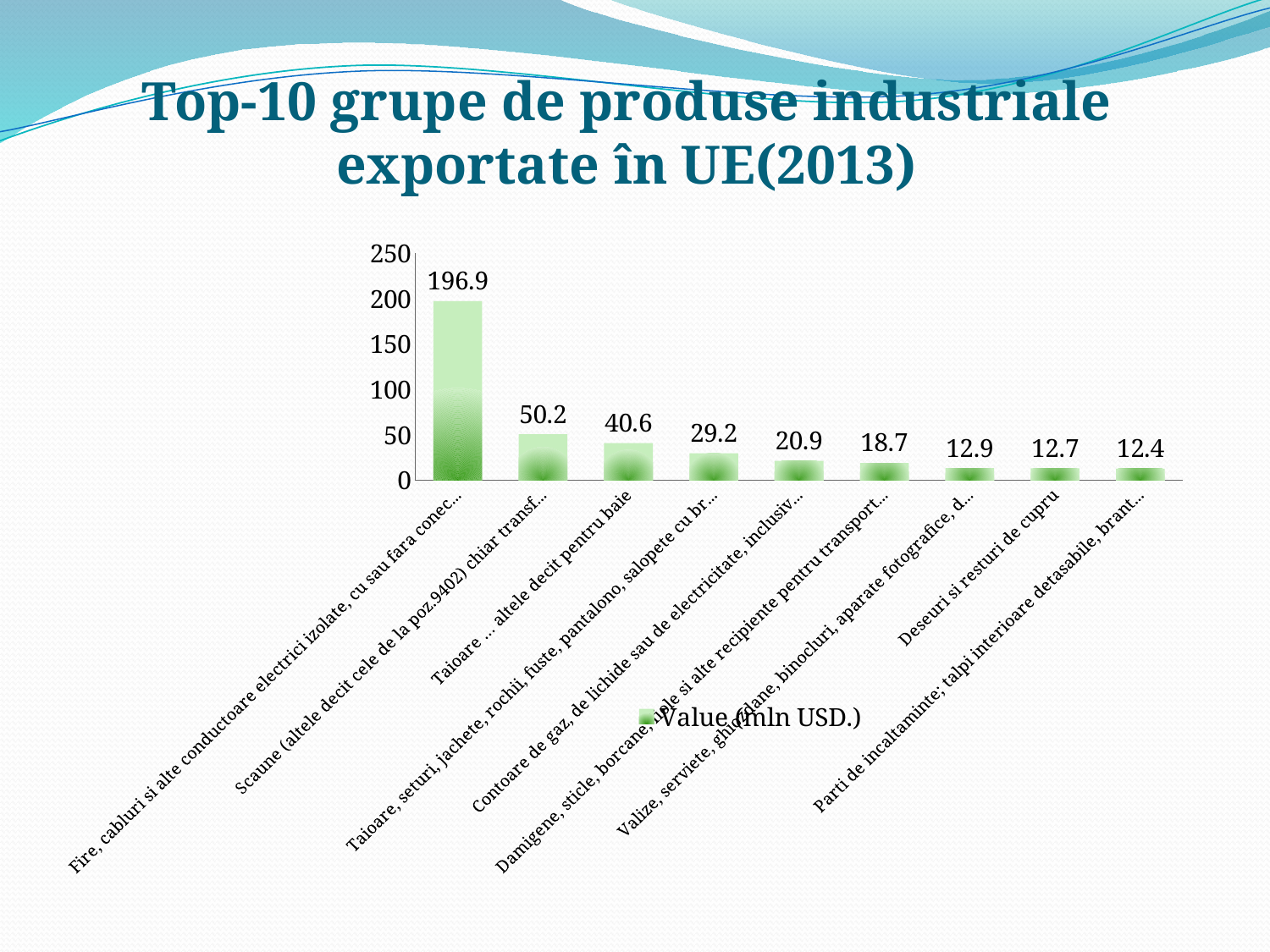
What is the value of the second bar from the left? 50.2 How many bars are plotted in the chart? 9 Do the values rise or fall from left to right along the x axis? Fall How many series does the legend list? 1 What type of chart is shown on the slide? Bar chart What is the difference between the first bar (196.9) and the second bar (50.2)? 146.7 What is the lowest value shown in the chart? 12.4 What is the value for 'Deseuri si resturi de cupru'? 12.7 Which is larger: the value for 'Taioare ... altele decit pentru baie' or the value for 'Deseuri si resturi de cupru'? Taioare ... altele decit pentru baie What is the value for 'Taioare ... altele decit pentru baie'? 40.6 What is the highest value shown in the chart? 196.9 What is the legend entry for the series in the chart? Value (mln USD.)